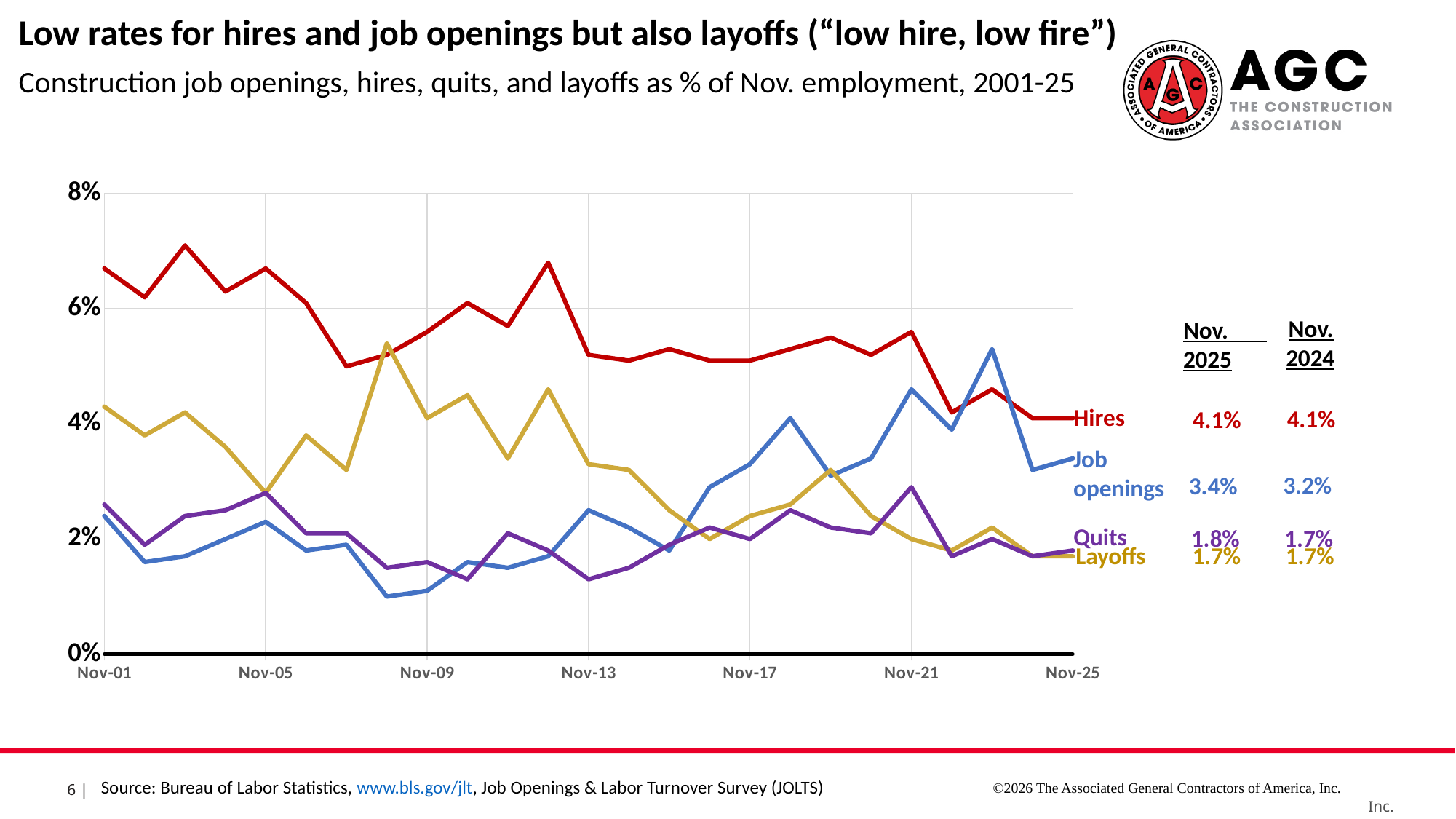
Overall, does the Hires line rise or fall from Nov-01 to Nov-25? fall What is the Hires rate for Nov. 2025? 4.1% Which series has the lowest rate in Nov. 2025? Layoffs What is the Layoffs rate for Nov. 2024? 1.7% Is the Job openings rate higher in Nov. 2025 or Nov. 2024? Nov. 2025 What kind of chart is shown on the slide? line chart What is the Job openings rate for Nov. 2024? 3.2% What is the difference between the Hires rate and the Job openings rate in Nov. 2025? 0.7 percentage points How many series does the chart plot? 4 Is the Hires rate at Nov-01 greater or less than 6%? greater What is the Quits rate for Nov. 2025? 1.8% Which series has the highest rate in Nov. 2025? Hires